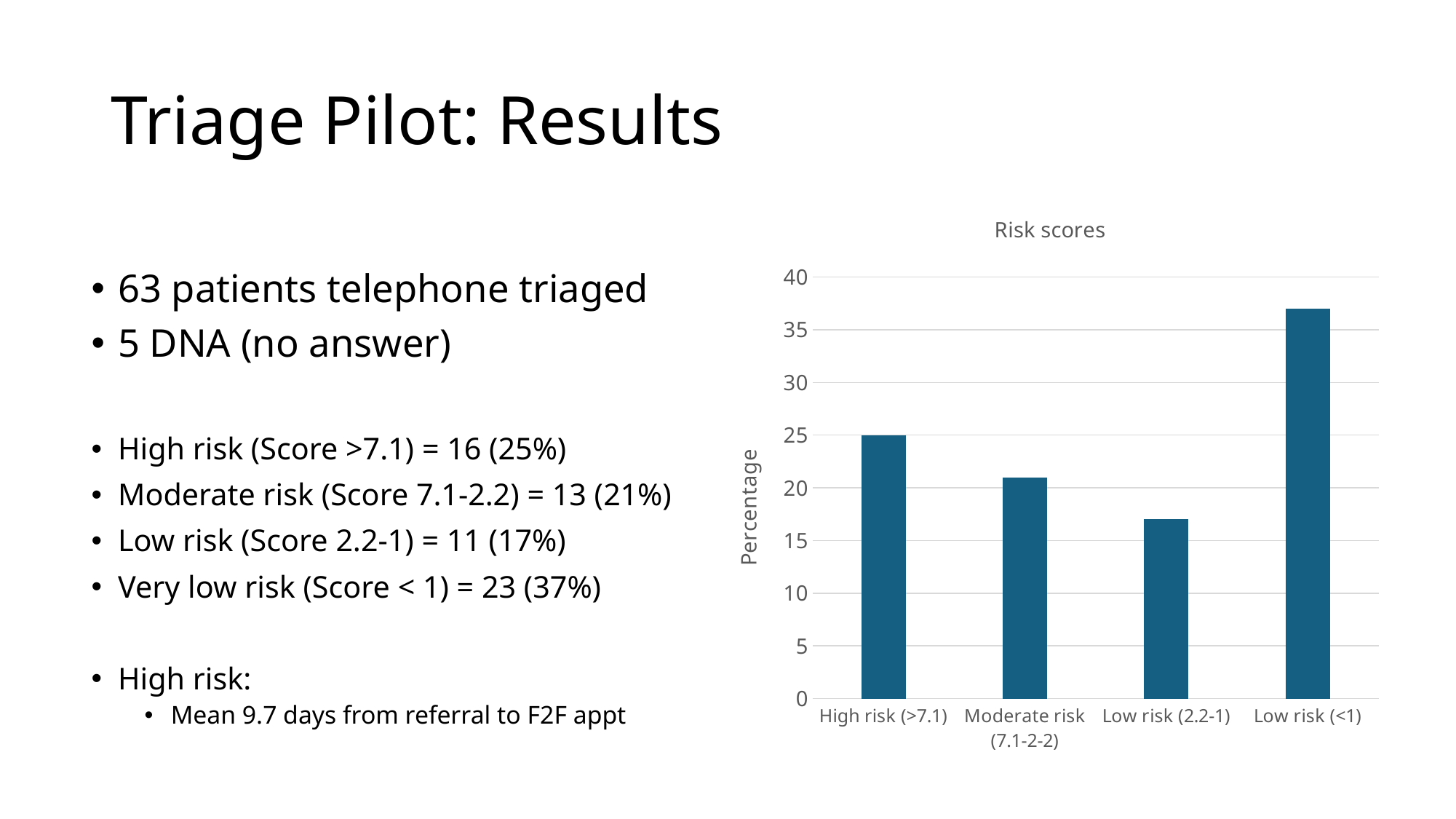
Which category has the highest percentage in the Risk scores chart? Low risk (<1) Is the value for Moderate risk (7.1-2-2) greater or less than 20? greater Is the value for Low risk (2.2-1) greater or less than 20? less What kind of chart is shown on the slide? bar chart Which is larger in the Risk scores chart: Low risk (<1) or High risk (>7.1)? Low risk (<1) Is the value for Low risk (<1) greater or less than 35? greater How many categories are plotted in the Risk scores chart? 4 What is the label on the vertical axis of the chart? Percentage Which category has the lowest percentage in the Risk scores chart? Low risk (2.2-1) What is the percentage for High risk (>7.1) in the Risk scores chart? 25 What is the title of the chart? Risk scores Which is larger in the Risk scores chart: High risk (>7.1) or Moderate risk (7.1-2-2)? High risk (>7.1)